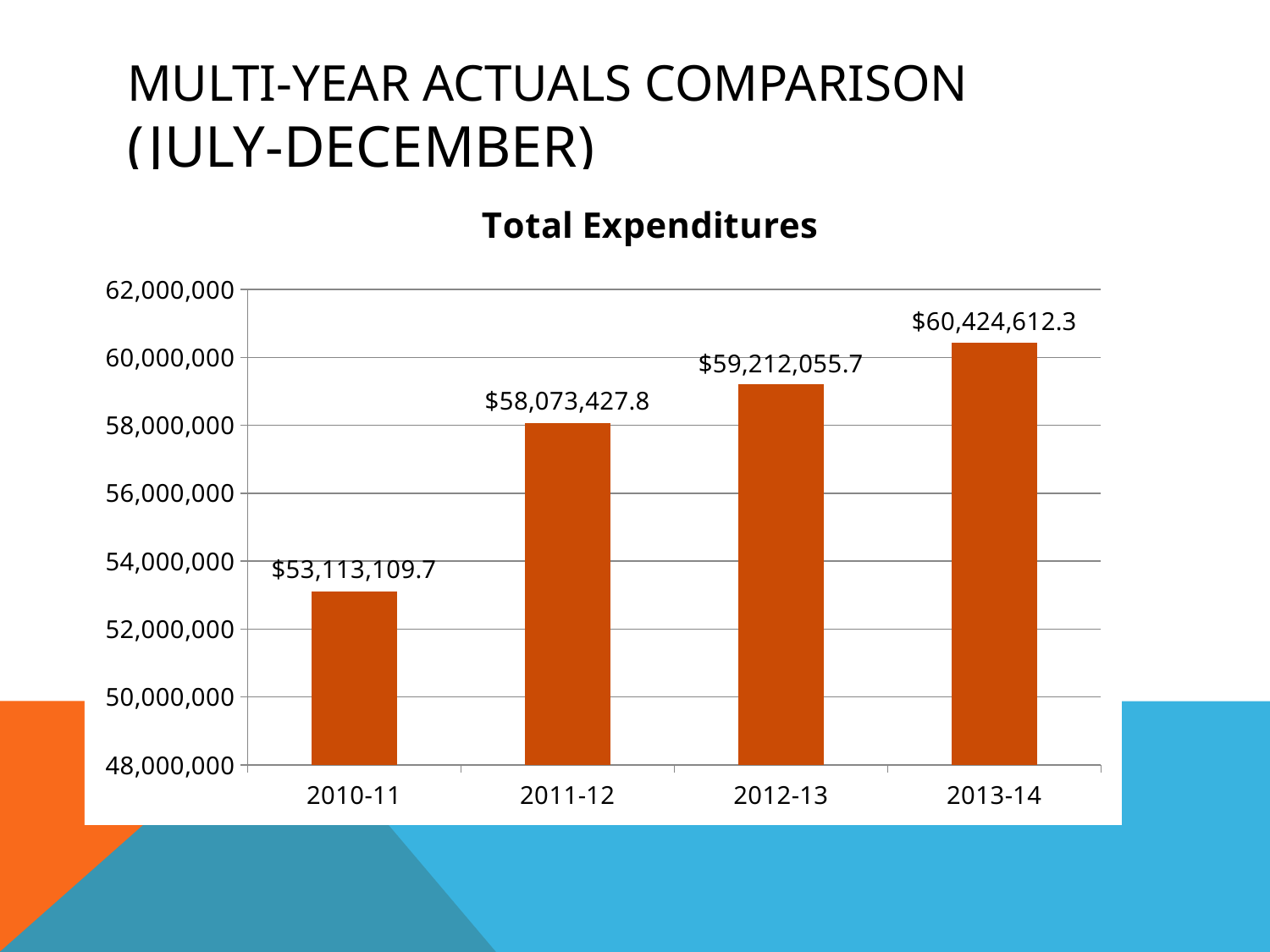
Which is larger, the total expenditures for 2011-12 or for 2012-13? 2012-13 What is the value for 2013-14 in the Total Expenditures chart? $60,424,612.3 What is the difference between the 2013-14 and 2010-11 total expenditures? $7,311,502.6 What kind of chart is shown on the slide? Bar chart Which year has the lowest total expenditures? 2010-11 What is the value for 2012-13 in the Total Expenditures chart? $59,212,055.7 What is the difference between the 2011-12 and 2010-11 total expenditures? $4,960,318.1 Is the value for 2013-14 greater or less than 60,000,000? greater Do total expenditures rise or fall from 2010-11 to 2013-14? Rise Which year has the highest total expenditures? 2013-14 What is the value for 2010-11 in the Total Expenditures chart? $53,113,109.7 How many years are shown in the Total Expenditures chart? 4